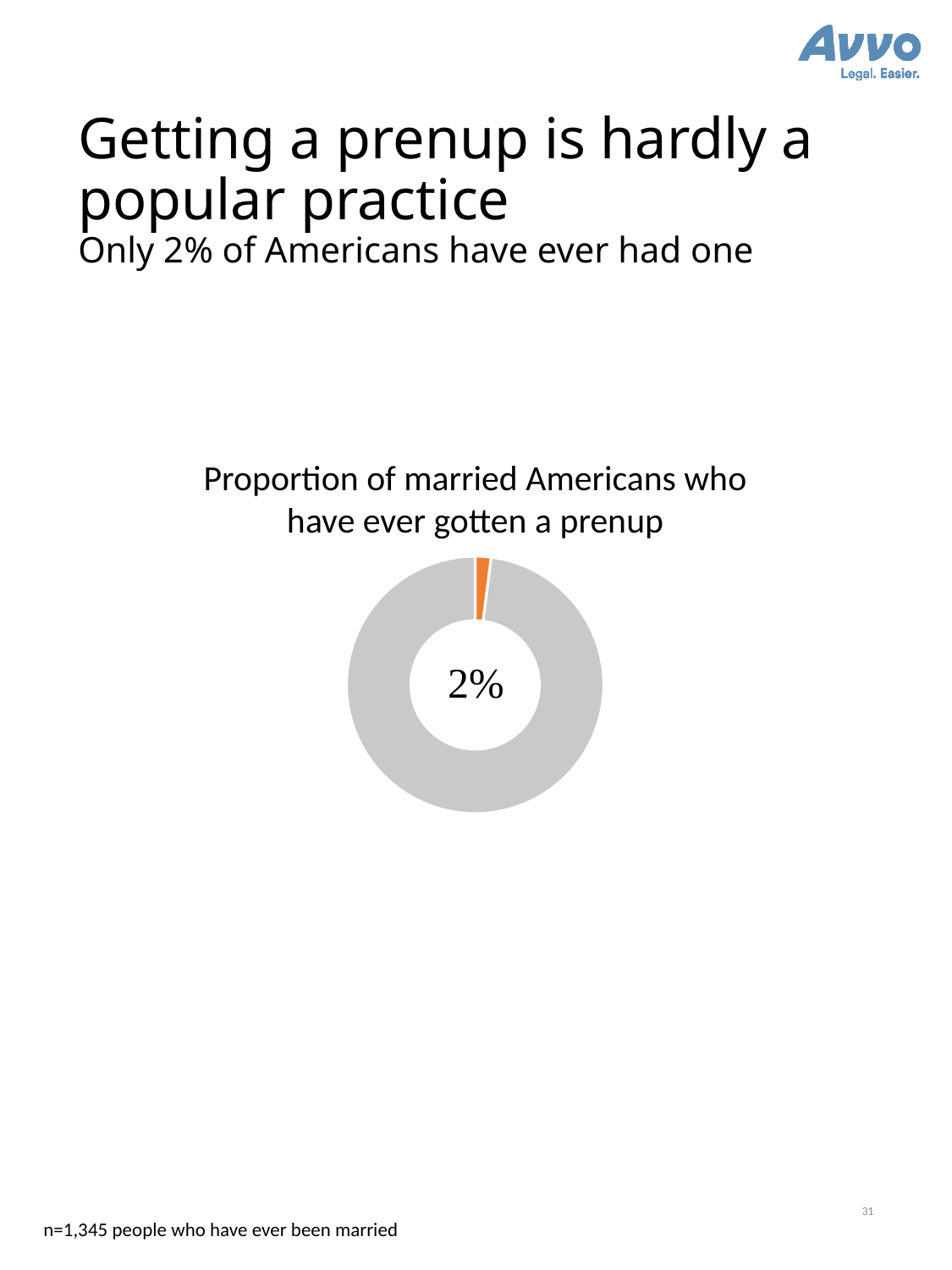
What colour is the slice representing married Americans who have gotten a prenup? Orange What is the title of the chart? Proportion of married Americans who have ever gotten a prenup What percentage is printed in the centre of the donut chart? 2% Which slice of the donut chart is larger, the grey one or the orange one? The grey one Is the share of married Americans who have ever gotten a prenup greater or less than 50%? less Which slice of the donut chart is the smallest? The orange slice (2%) What share of the donut chart does the orange slice represent? 2% What kind of chart is shown on the slide? Donut (pie) chart How many slices does the donut chart have? 2